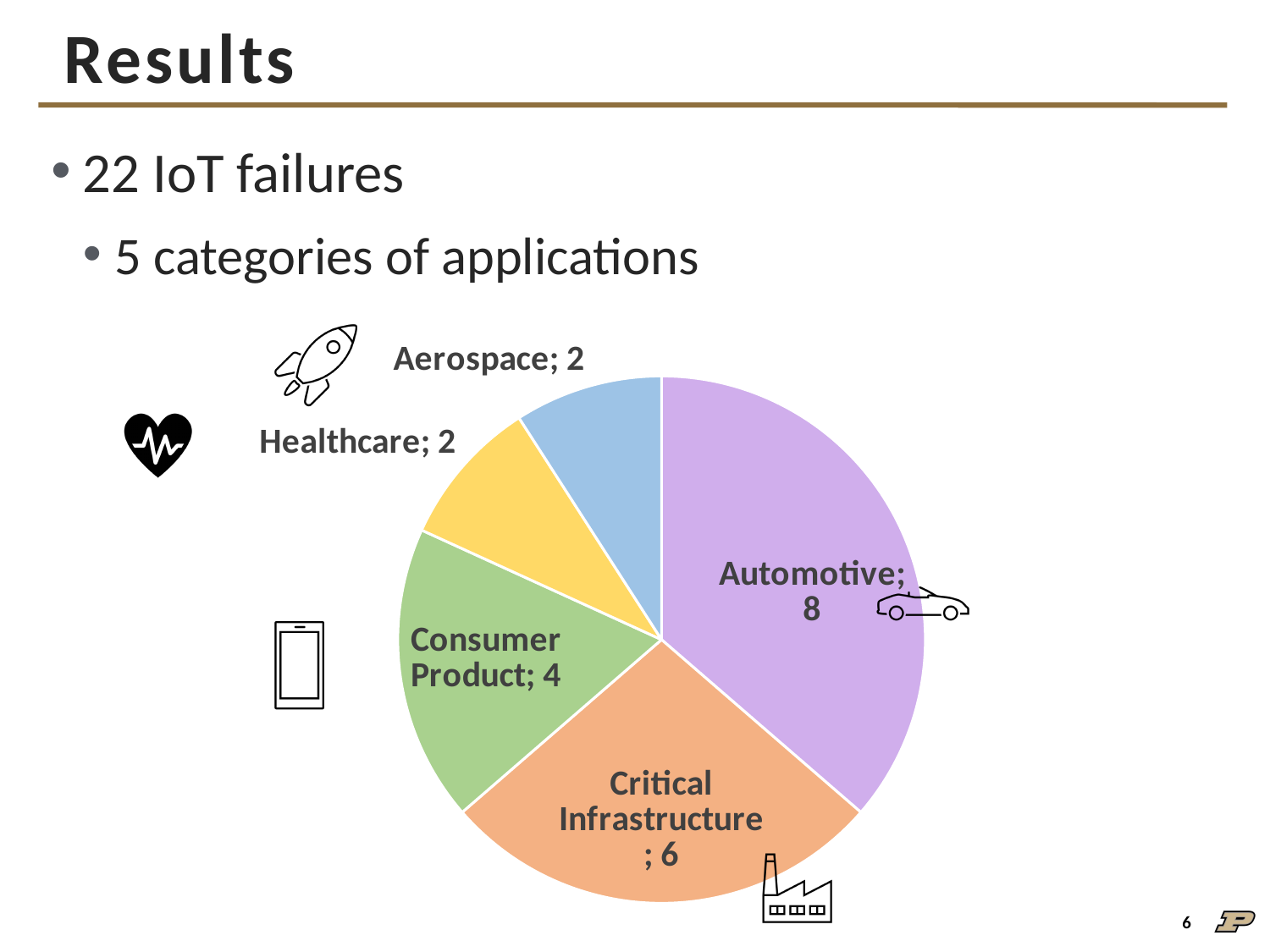
What is the total of all slices in the pie chart? 22 What is the value for Critical Infrastructure? 6 Which is larger, Critical Infrastructure or Consumer Product? Critical Infrastructure Which category has the largest slice of the pie? Automotive What is the value for Consumer Product? 4 How many categories are shown in the pie chart? 5 What colour is the Automotive slice? purple What share of the pie does Consumer Product represent? 4/22 What is the value for Healthcare? 2 What kind of chart is shown on the slide? pie chart How many IoT failures are attributed to Automotive? 8 What is the difference between the Automotive and Consumer Product values? 4